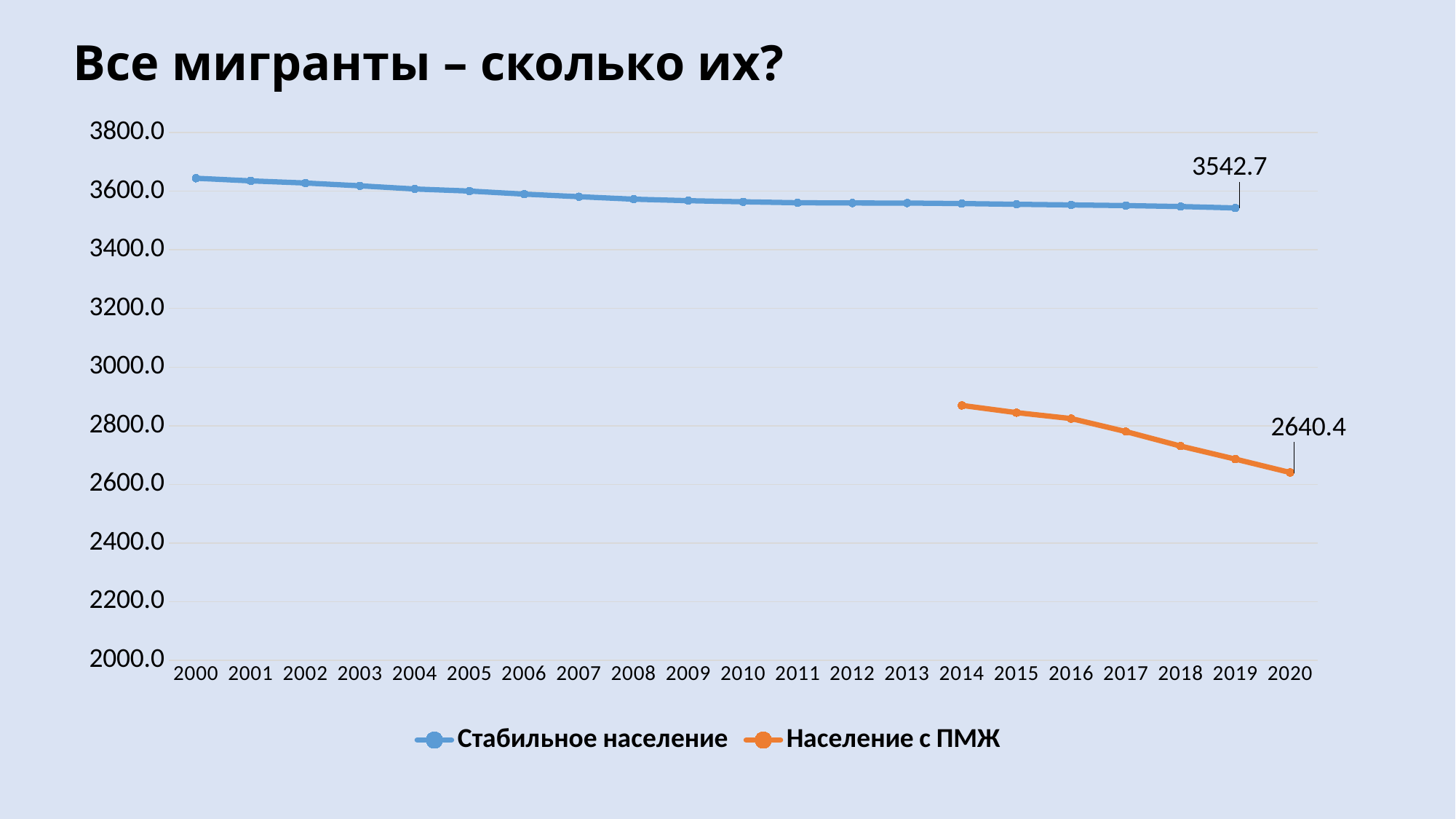
What is the difference between the labelled values 3542.7 and 2640.4 shown on the chart? 902.3 What is the value of the Население с ПМЖ series in 2020? 2640.4 Does the Стабильное население series rise or fall from 2000 to 2019? fall How many years are shown on the x axis? 21 What is the title of the chart on the slide? Все мигранты – сколько их? Is the value for Стабильное население in 2000 greater or less than 3600.0? greater How many series does the legend list? 2 Is the value for Население с ПМЖ in 2014 greater or less than 3000.0? less Which series has higher values, Стабильное население or Население с ПМЖ? Стабильное население What is the value of the last labelled point of the Стабильное население series? 3542.7 What type of chart is shown on the slide? line chart Does the Население с ПМЖ series rise or fall from 2014 to 2020? fall